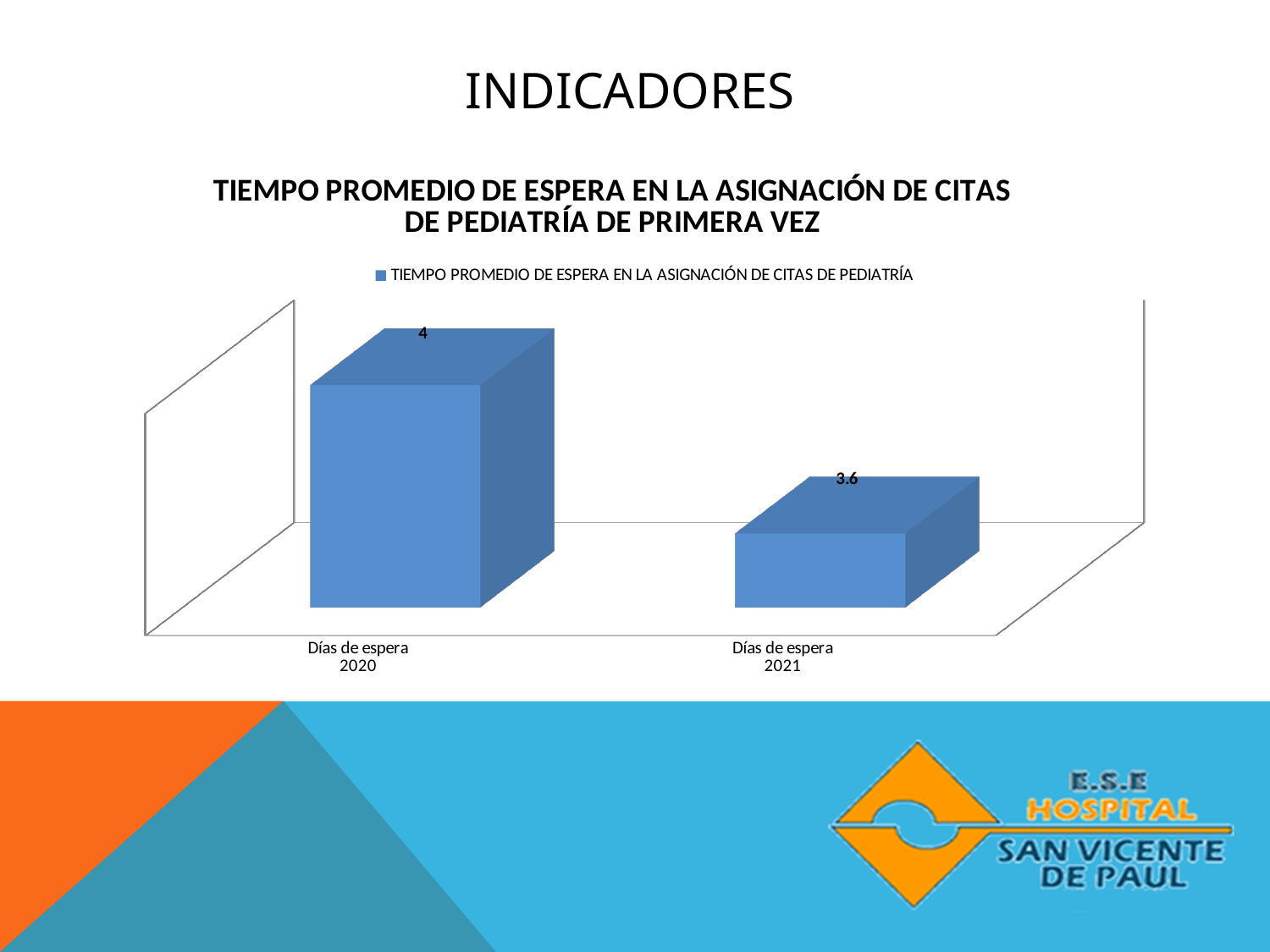
What is the value for Días de espera 2020? 4 What is the value for Días de espera 2021? 3.6 How many series does the legend list? 1 What colour are the bars in the chart? blue What kind of chart is shown? bar chart How many categories are shown on the x axis? 2 Which category has the lowest value? Días de espera 2021 Which is larger, the value for Días de espera 2020 or Días de espera 2021? Días de espera 2020 What is the difference between the values for Días de espera 2020 and Días de espera 2021? 0.4 What is the title of the chart? TIEMPO PROMEDIO DE ESPERA EN LA ASIGNACIÓN DE CITAS DE PEDIATRÍA DE PRIMERA VEZ Which category has the highest value? Días de espera 2020 Do the values rise or fall from 2020 to 2021? fall